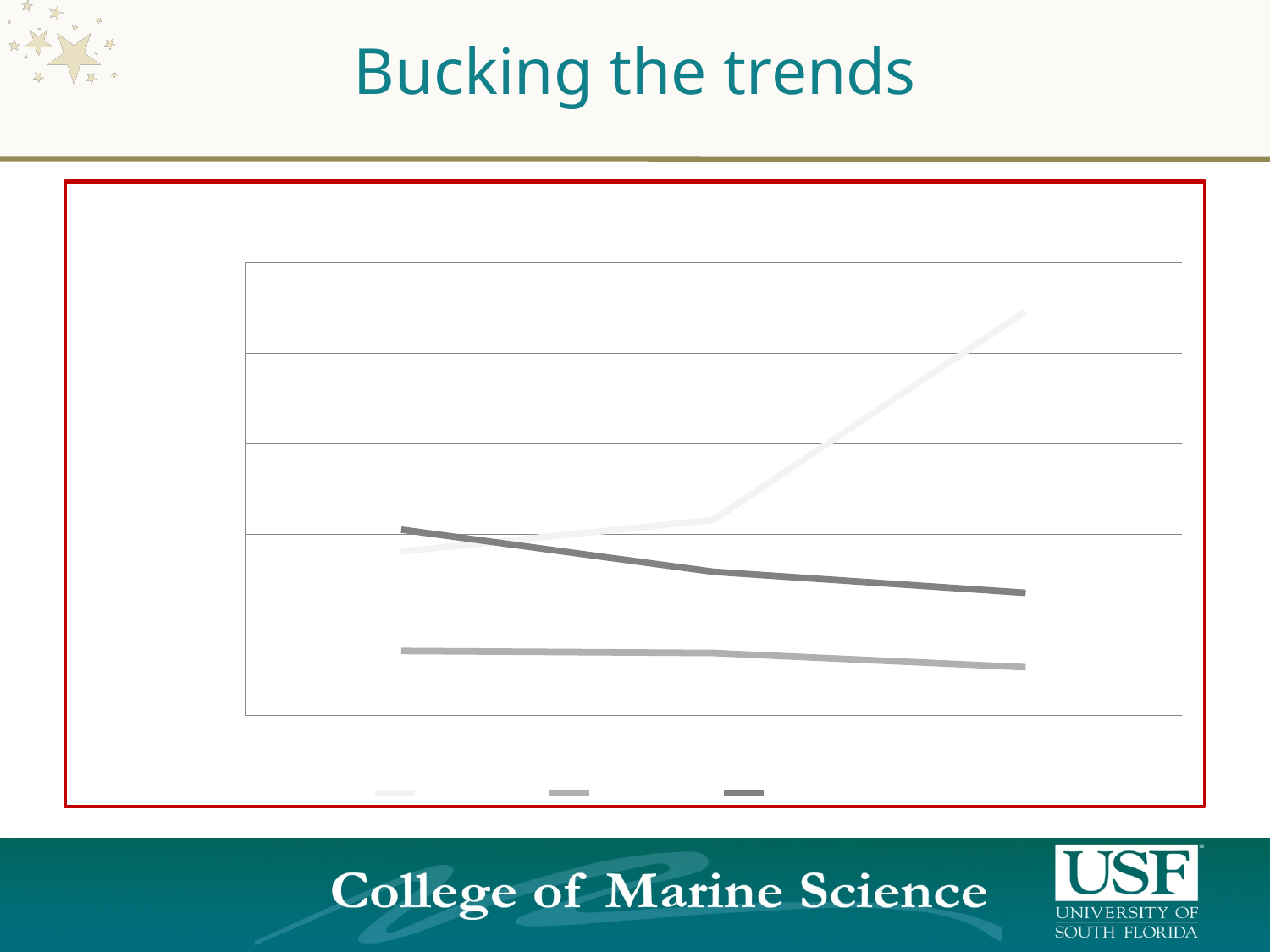
How many lines are plotted on the chart? 3 Does the lightest (white) line rise or fall from left to right? rise How many horizontal gridlines are drawn on the chart, including the top and bottom borders? 6 What is the title of the slide containing the chart? Bucking the trends Does the dark grey line rise or fall from left to right? fall What kind of chart is shown on the slide? line chart Which line is lowest at the right side of the chart? the medium grey line How many legend entries are shown below the chart? 3 How many data points does each line on the chart have? 3 Which line ends highest at the right side of the chart? the white line At the left side of the chart, which is higher: the white line or the dark grey line? the dark grey line Does the medium grey line at the bottom rise or fall from left to right? fall